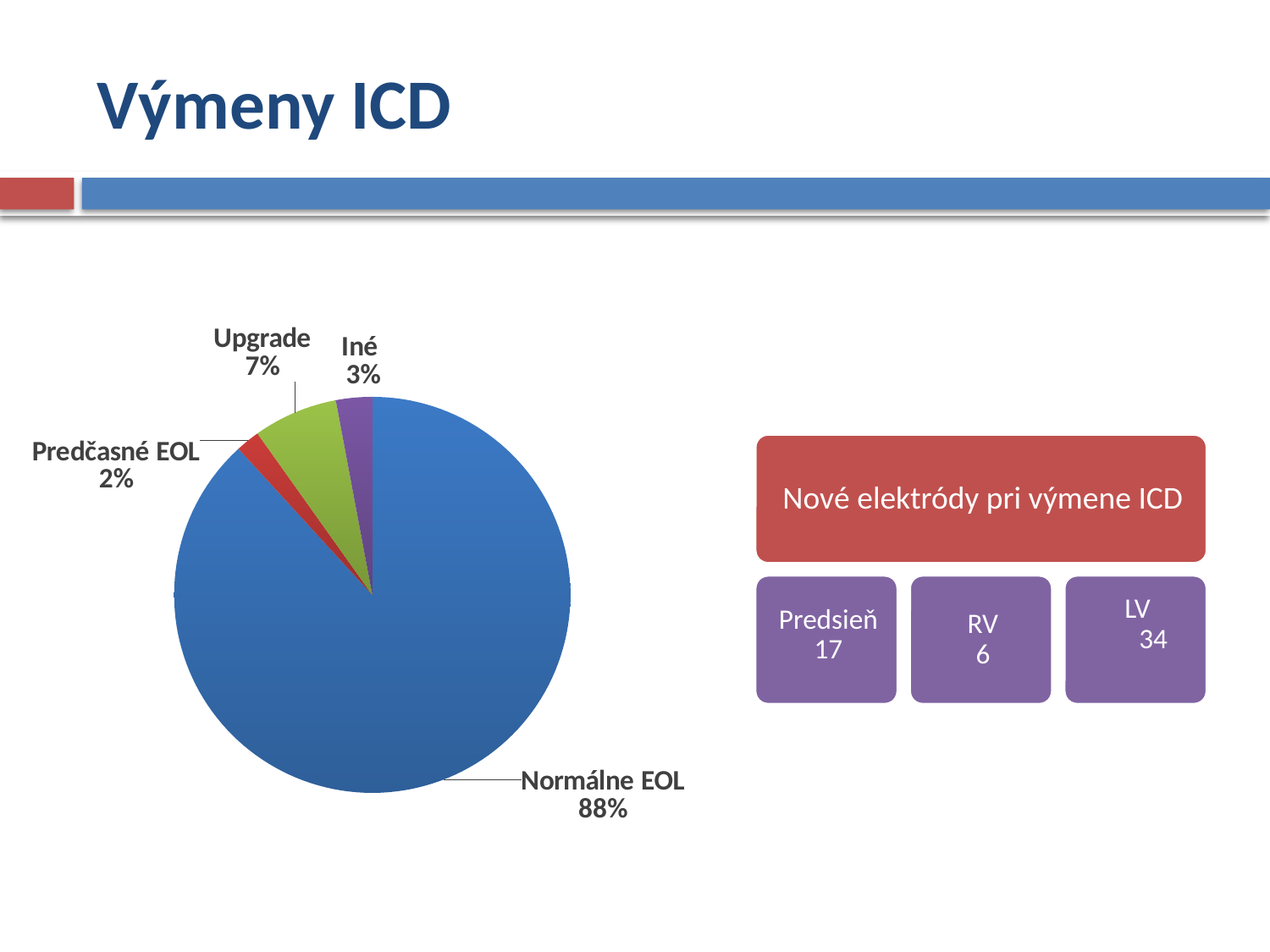
How many slices does the pie chart have? 4 Which category has the smallest slice of the pie? Predčasné EOL What colour is the Normálne EOL slice? blue What is the difference in percentage points between Normálne EOL and Upgrade? 81 What share of the pie does Normálne EOL represent? 88% Which category has the largest slice of the pie? Normálne EOL What is the difference in percentage points between Upgrade and Iné? 4 What share of the pie does Predčasné EOL represent? 2% What share of the pie does Iné represent? 3% What kind of chart is shown on the slide? pie chart Which is larger, the share for Upgrade or the share for Iné? Upgrade